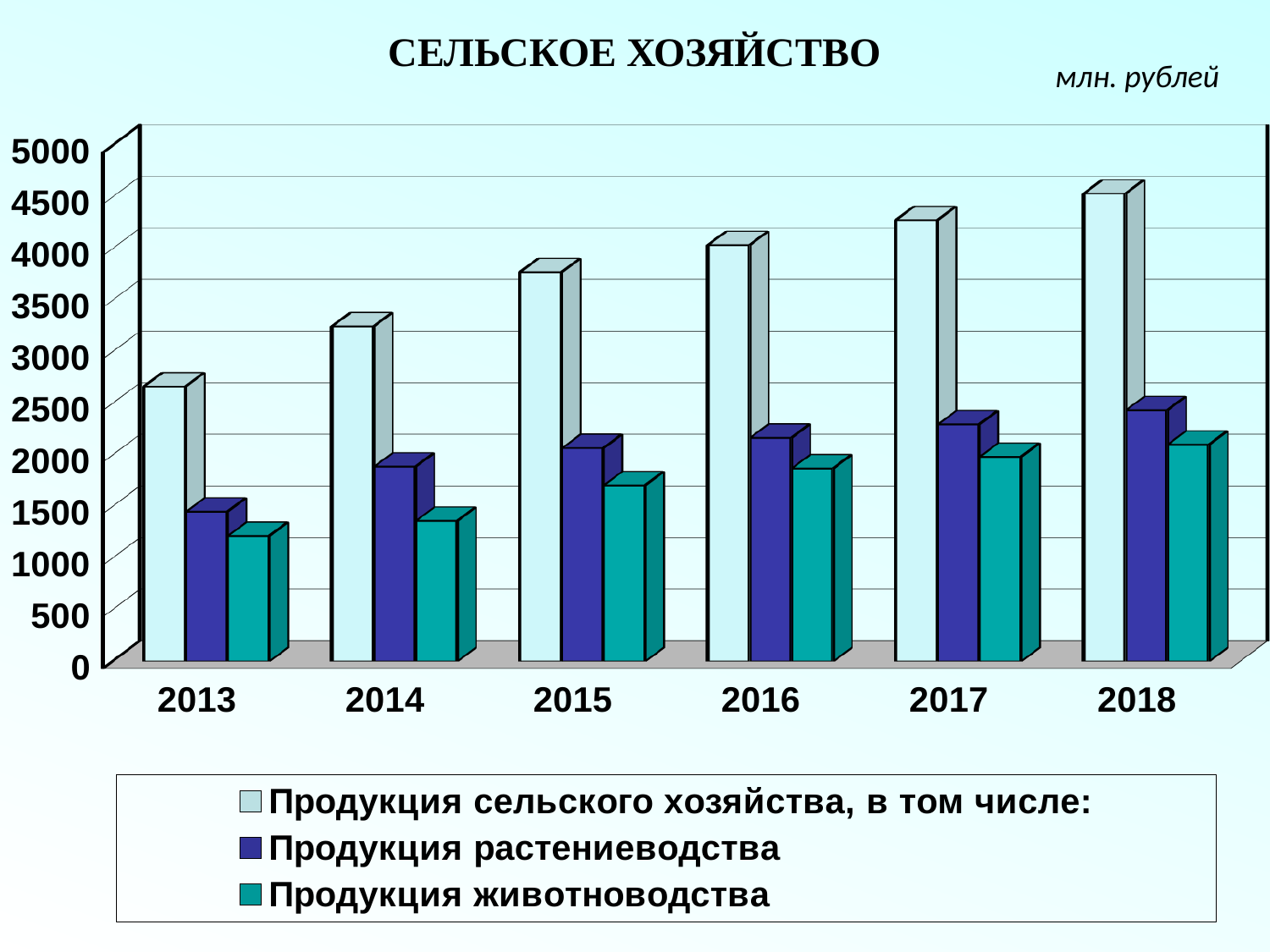
Is the value for Продукция сельского хозяйства in 2018 greater or less than 4000? greater In which year is the value for Продукция сельского хозяйства the highest? 2018 How many years are shown on the x axis? 6 In 2013, which is larger: Продукция растениеводства or Продукция животноводства? Продукция растениеводства Is the value for Продукция животноводства in 2014 greater or less than 1500? less In which year is the value for Продукция животноводства the lowest? 2013 Do the values for Продукция сельского хозяйства rise or fall from 2013 to 2018? rise Is the value for Продукция животноводства in 2018 greater or less than 1500? greater How many series does the legend list? 3 What kind of chart is shown on the slide? bar chart What unit of measurement is indicated for the chart? млн. рублей